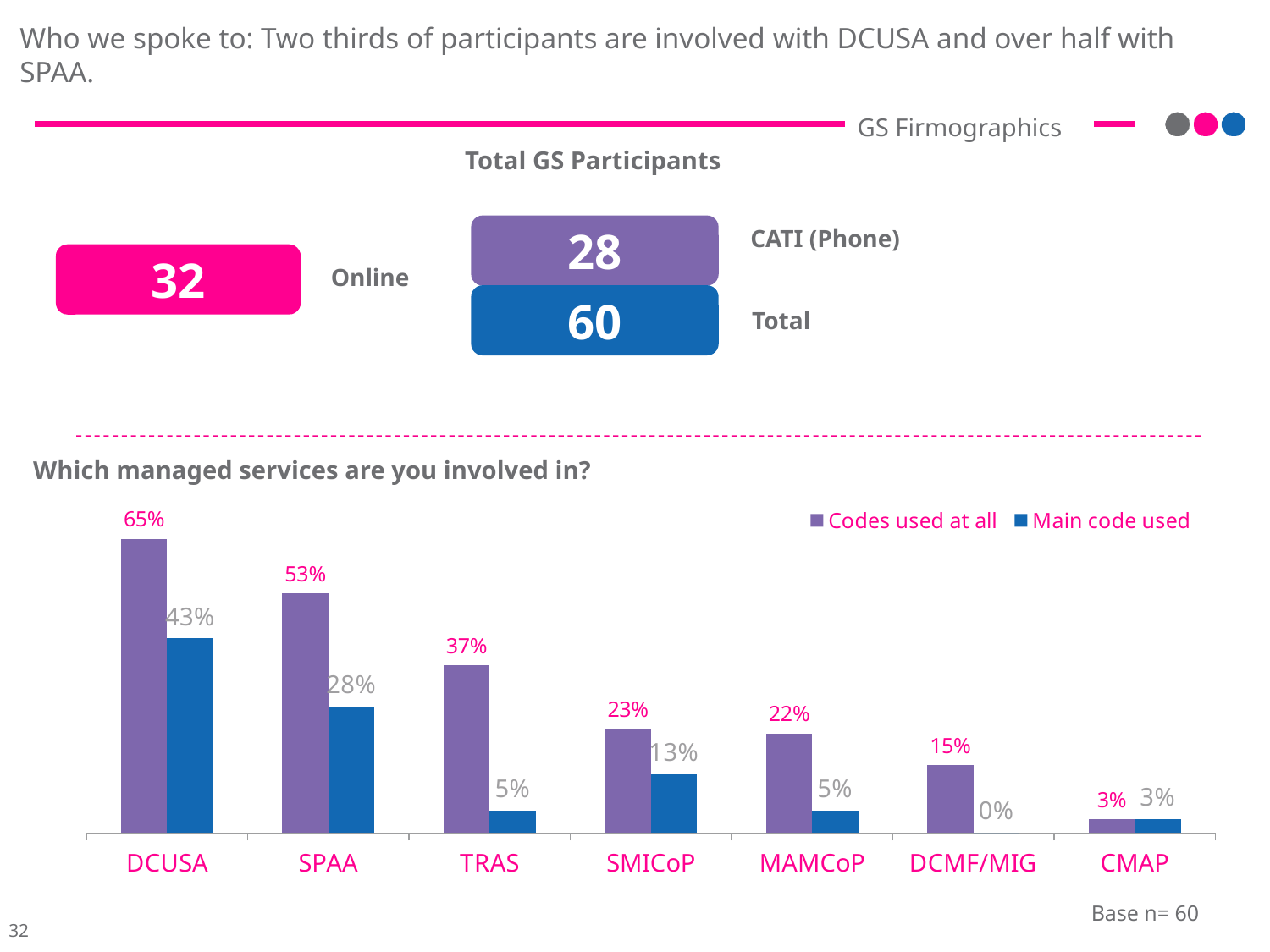
Which managed service has the lowest value for 'Codes used at all'? CMAP What is the value for 'Main code used' for DCMF/MIG? 0% Which is larger for SMICoP: 'Codes used at all' or 'Main code used'? Codes used at all What is the base sample size shown for the chart? 60 How many managed services are shown on the x axis of the chart? 7 What kind of chart is used to show which managed services participants are involved in? Bar chart How many series does the chart legend list? 2 Do the 'Codes used at all' values rise or fall from DCUSA to CMAP along the x axis? Fall What is the value for 'Main code used' for SPAA? 28% Which managed service has the highest value for 'Codes used at all'? DCUSA What is the value for 'Codes used at all' for DCUSA? 65% What is the difference between 'Codes used at all' and 'Main code used' for TRAS? 32%